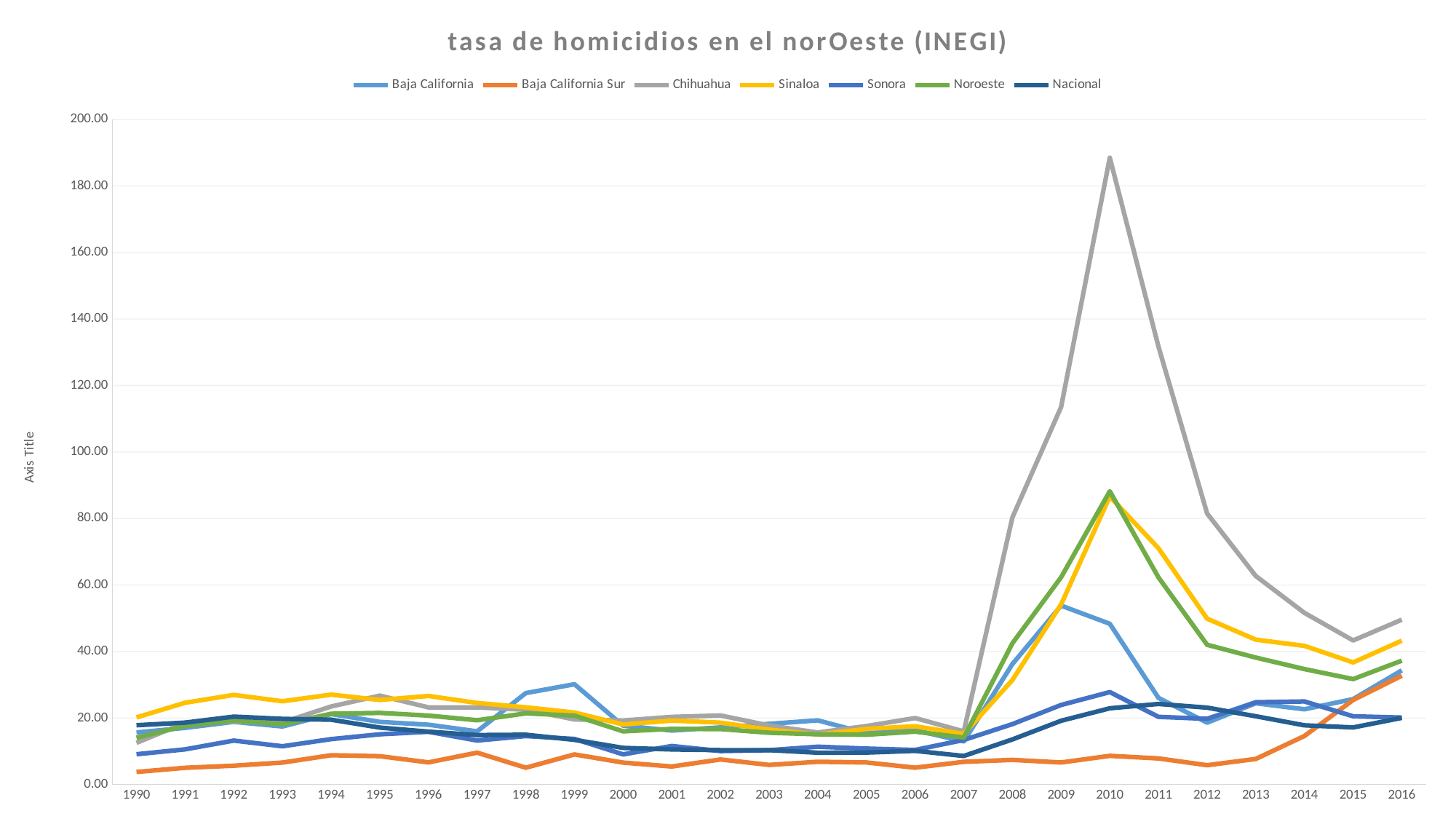
Is the value for Chihuahua in 2010 greater or less than 180? greater How many years are plotted along the x axis? 27 What is the title of the chart? tasa de homicidios en el norOeste (INEGI) Does the Chihuahua line rise or fall between 2010 and 2015? fall Which series reaches the highest value on the chart? Chihuahua In 2010, which is larger: Chihuahua or Sinaloa? Chihuahua Which series has the lowest value in 1990? Baja California Sur Is the value for Noroeste in 2010 greater or less than 80? greater In which year does the Chihuahua line reach its peak? 2010 How many series does the legend list? 7 What kind of chart is shown on the slide? line chart Is the value for Nacional in 2016 greater or less than 40? less